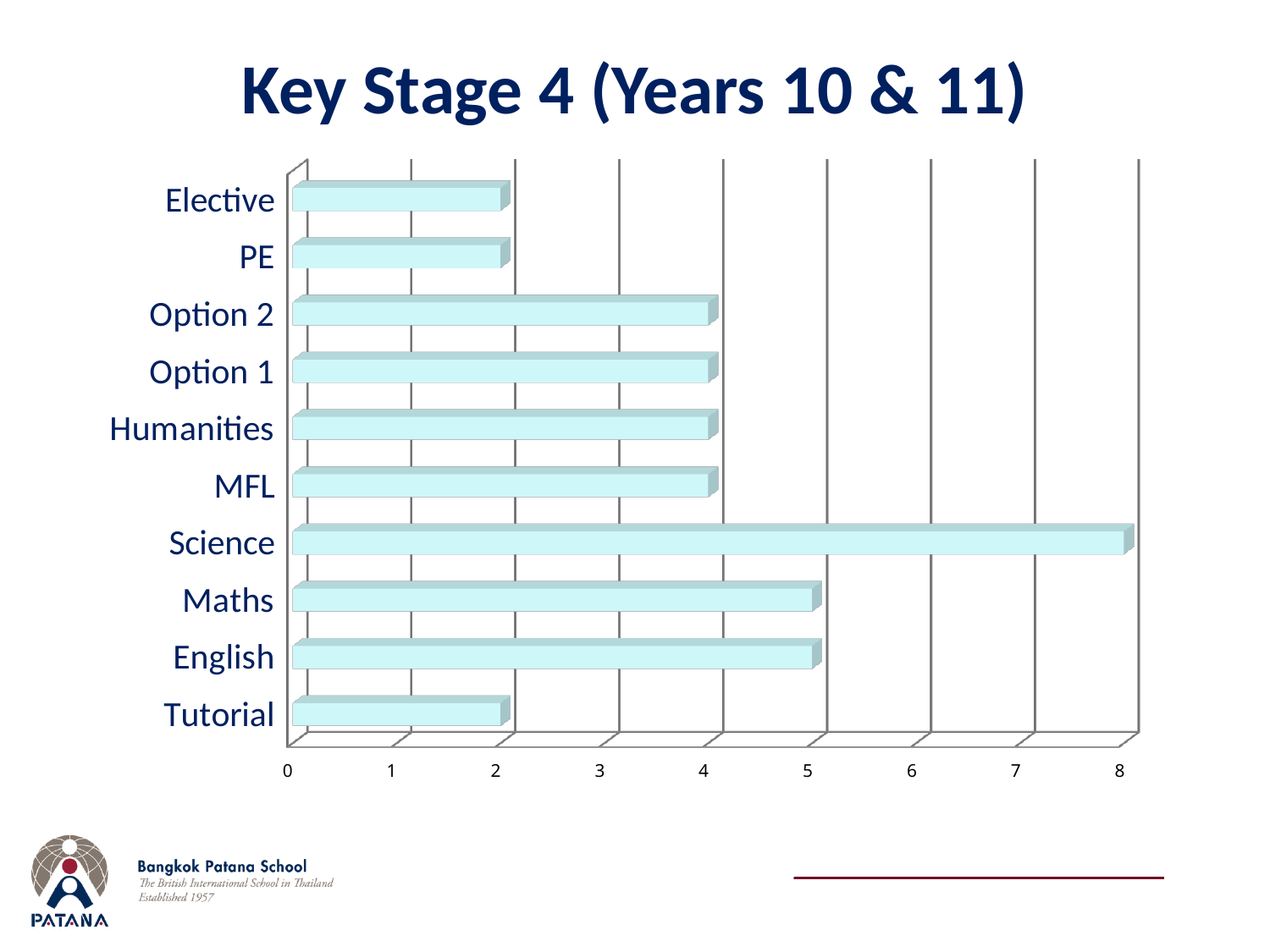
What is the difference between the values for Science and Maths? 3 What is the value for Tutorial? 2 What is the value for Science? 8 Is the value for Science greater or less than 6? greater What is the value for Maths? 5 How many categories are shown on the chart? 10 What is the difference between the values for English and PE? 3 What is the value for Humanities? 4 What is the title of the slide? Key Stage 4 (Years 10 & 11) Which is larger, the value for Option 1 or the value for Elective? Option 1 What type of chart is shown on the slide? bar chart Which category has the highest value? Science